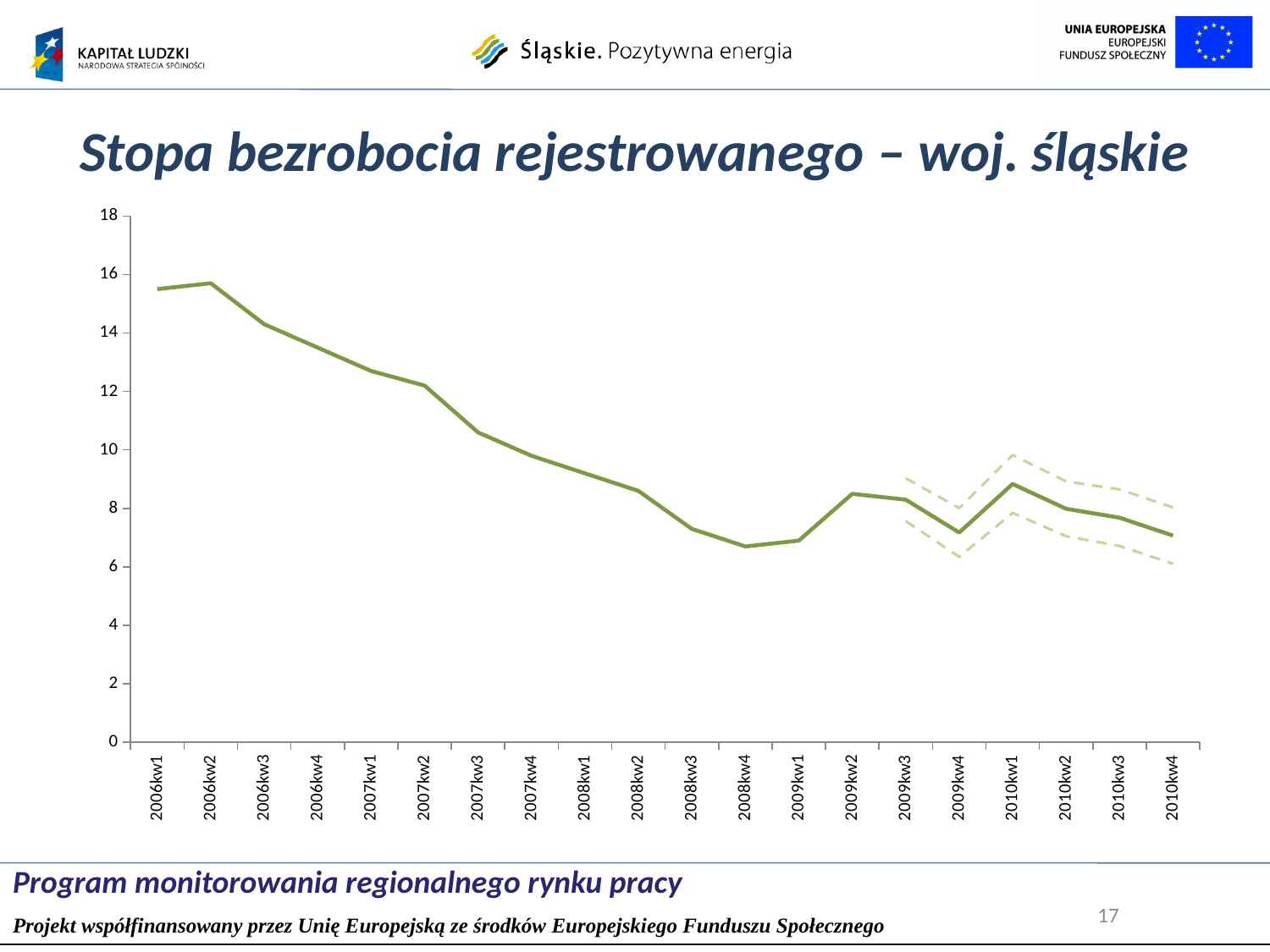
Does the unemployment rate rise or fall from 2006kw1 to 2008kw4? fall Which is larger, the value for 2009kw2 or the value for 2009kw4? 2009kw2 What is the highest tick value shown on the y axis? 18 Is the value for 2008kw1 greater or less than 10? less Is the value for 2006kw1 greater or less than 14? greater Is the value for 2010kw4 greater or less than 6? greater What kind of chart is shown on the slide? line chart What is the title of the chart? Stopa bezrobocia rejestrowanego – woj. śląskie How many quarters are plotted along the x axis? 20 Which is larger, the value for 2006kw1 or the value for 2010kw4? 2006kw1